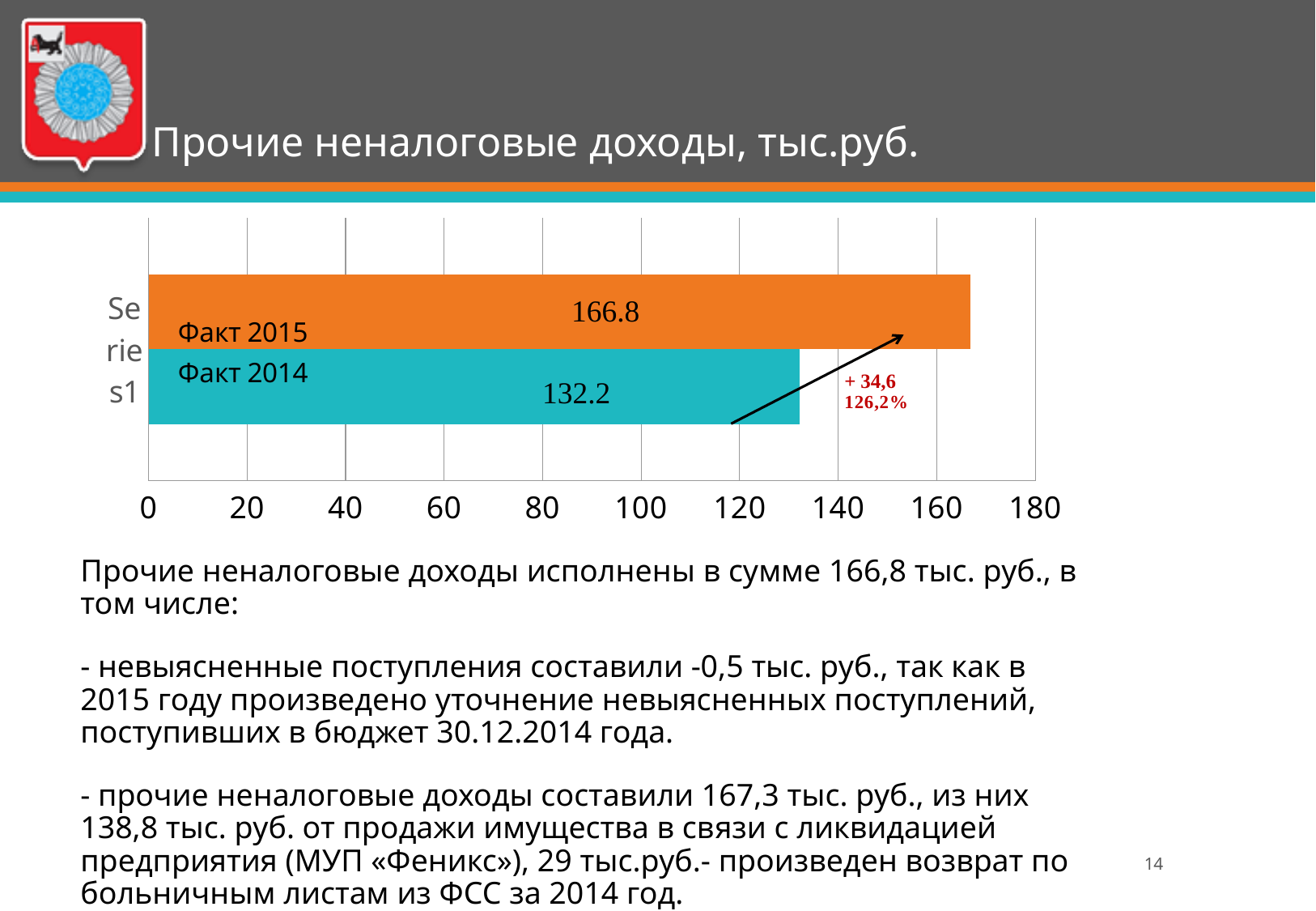
What is the title of the slide containing the chart? Прочие неналоговые доходы, тыс.руб. Is the value for Факт 2014 greater or less than 140? less Is the value for Факт 2015 greater or less than 160? greater Is the value for Факт 2014 larger or smaller than the value for Факт 2015? smaller What is the difference between the Факт 2015 and Факт 2014 values? 34.6 How many bars are plotted in the chart? 2 What is the value for Факт 2015? 166.8 What is the value for Факт 2014? 132.2 What is the maximum value shown on the horizontal axis of the chart? 180 Which bar has the higher value, Факт 2015 or Факт 2014? Факт 2015 What kind of chart is shown on the slide? bar chart Which bar has the lower value? Факт 2014